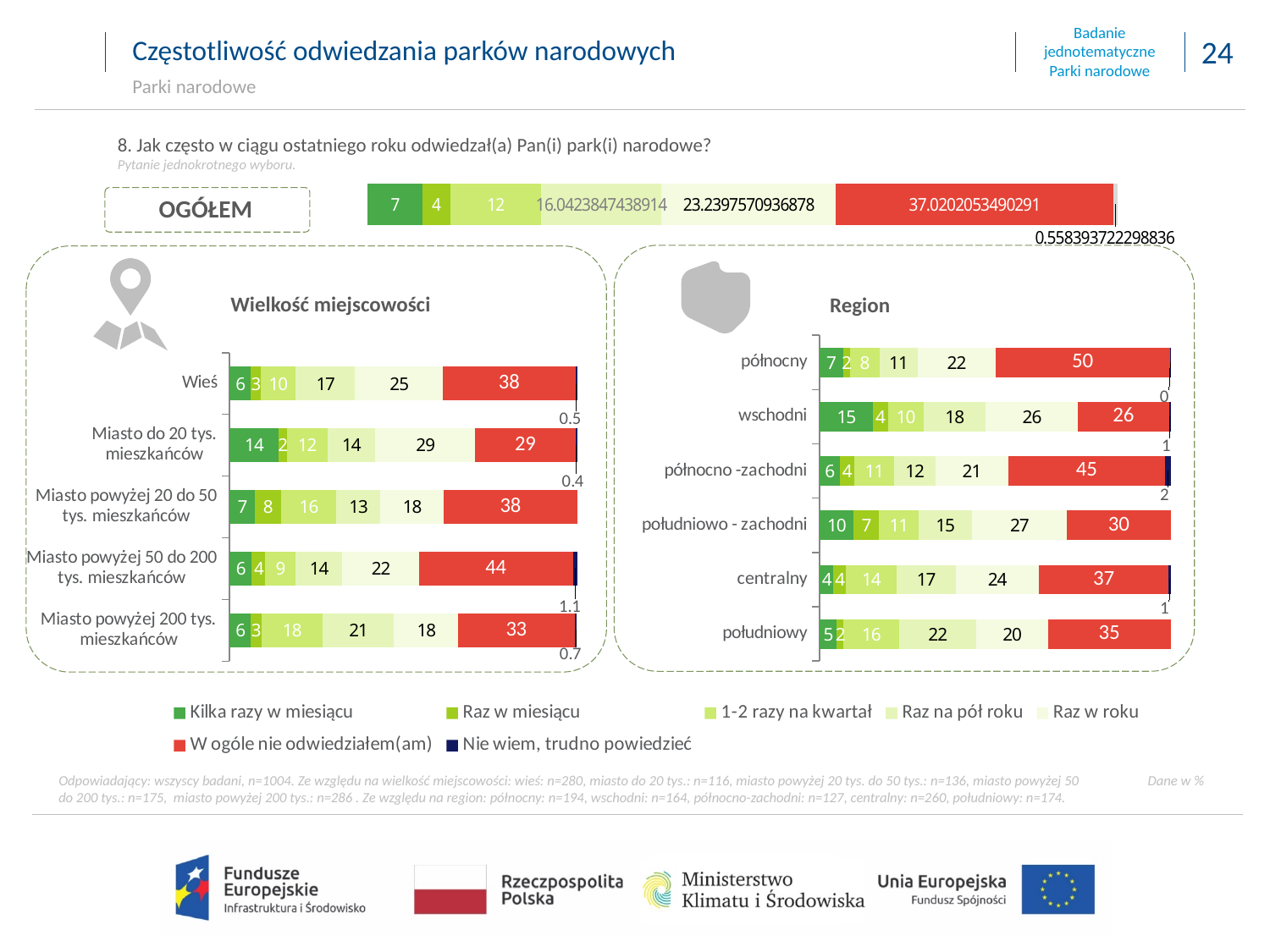
How many regions are shown in the Region chart? 6 In the Region chart, which region has the highest value for 'W ogóle nie odwiedziałem(am)'? północny In the Region chart, what is the value of 'Raz na pół roku' for the południowy region? 22 In the OGÓŁEM chart, what is the value for 'Kilka razy w miesiącu'? 7 In the Wielkość miejscowości chart, which category has the highest value for 'Kilka razy w miesiącu'? Miasto do 20 tys. mieszkańców In the Region chart, which has the larger 'Raz w roku' value: wschodni or centralny? wschodni What kind of chart is used on this slide? Stacked bar chart How many categories are shown in the Wielkość miejscowości chart? 5 In the Wielkość miejscowości chart, what is the value of 'W ogóle nie odwiedziałem(am)' for 'Miasto powyżej 50 do 200 tys. mieszkańców'? 44 In the Region chart, what is the value of 'W ogóle nie odwiedziałem(am)' for the północny region? 50 How many series does the legend list? 7 In the Wielkość miejscowości chart, what is the difference between the 'W ogóle nie odwiedziałem(am)' values for Wieś and 'Miasto powyżej 200 tys. mieszkańców'? 5